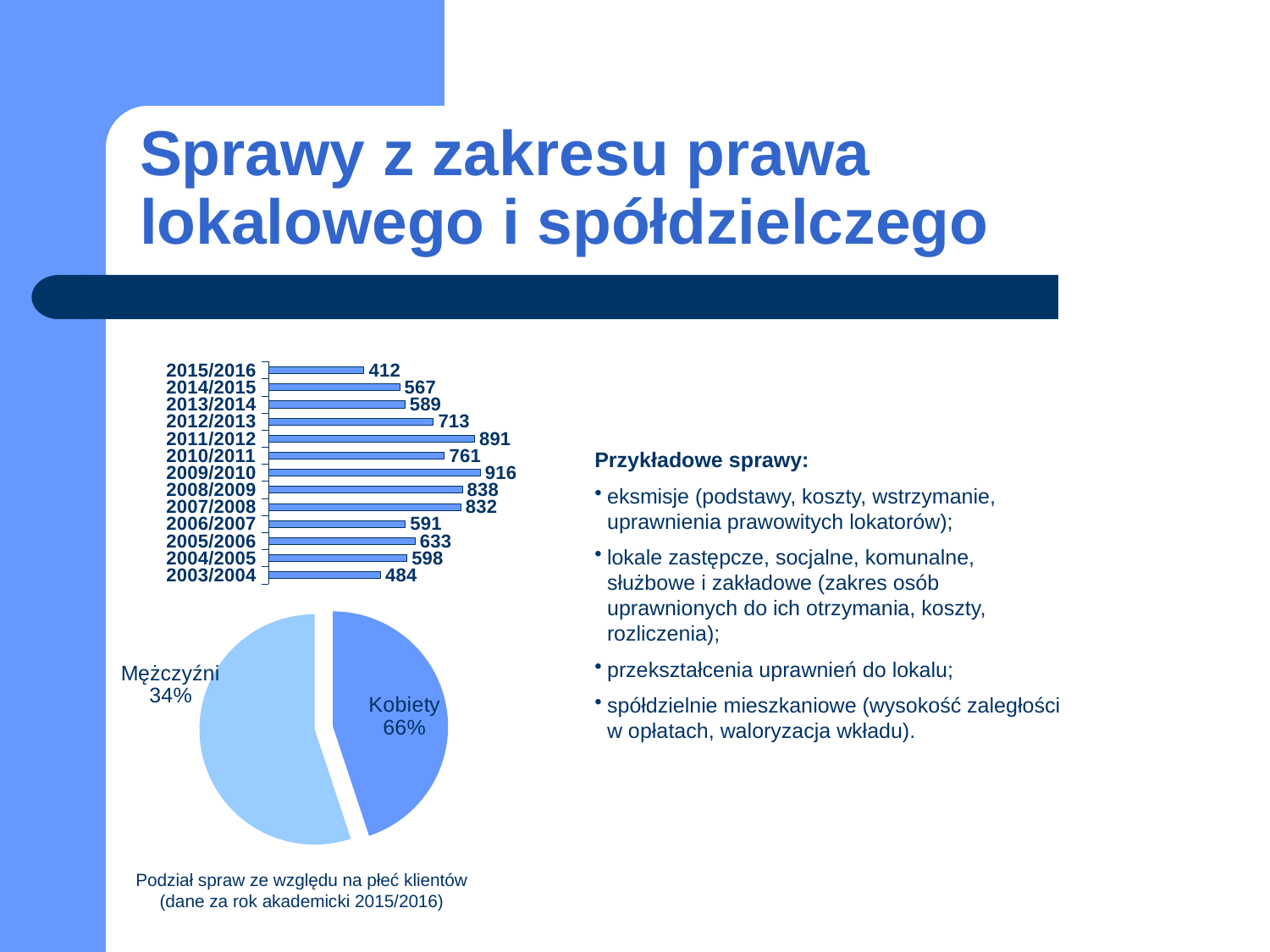
In the pie chart, what share of cases is attributed to Kobiety? 66% In the bar chart, what is the difference between the values for 2011/2012 and 2012/2013? 178 In the bar chart, what is the value for 2015/2016? 412 What kind of chart is the upper chart on the slide? Bar chart In the bar chart, which academic year has the lowest value? 2015/2016 In the pie chart, what share of cases is attributed to Mężczyźni? 34% In the bar chart, which academic year has the highest value? 2009/2010 In the bar chart, what is the value for 2009/2010? 916 How many academic years are shown in the bar chart? 13 In the bar chart, what is the value for 2003/2004? 484 In the bar chart, which is larger: the value for 2008/2009 or the value for 2007/2008? 2008/2009 What is the caption below the pie chart? Podział spraw ze względu na płeć klientów (dane za rok akademicki 2015/2016)